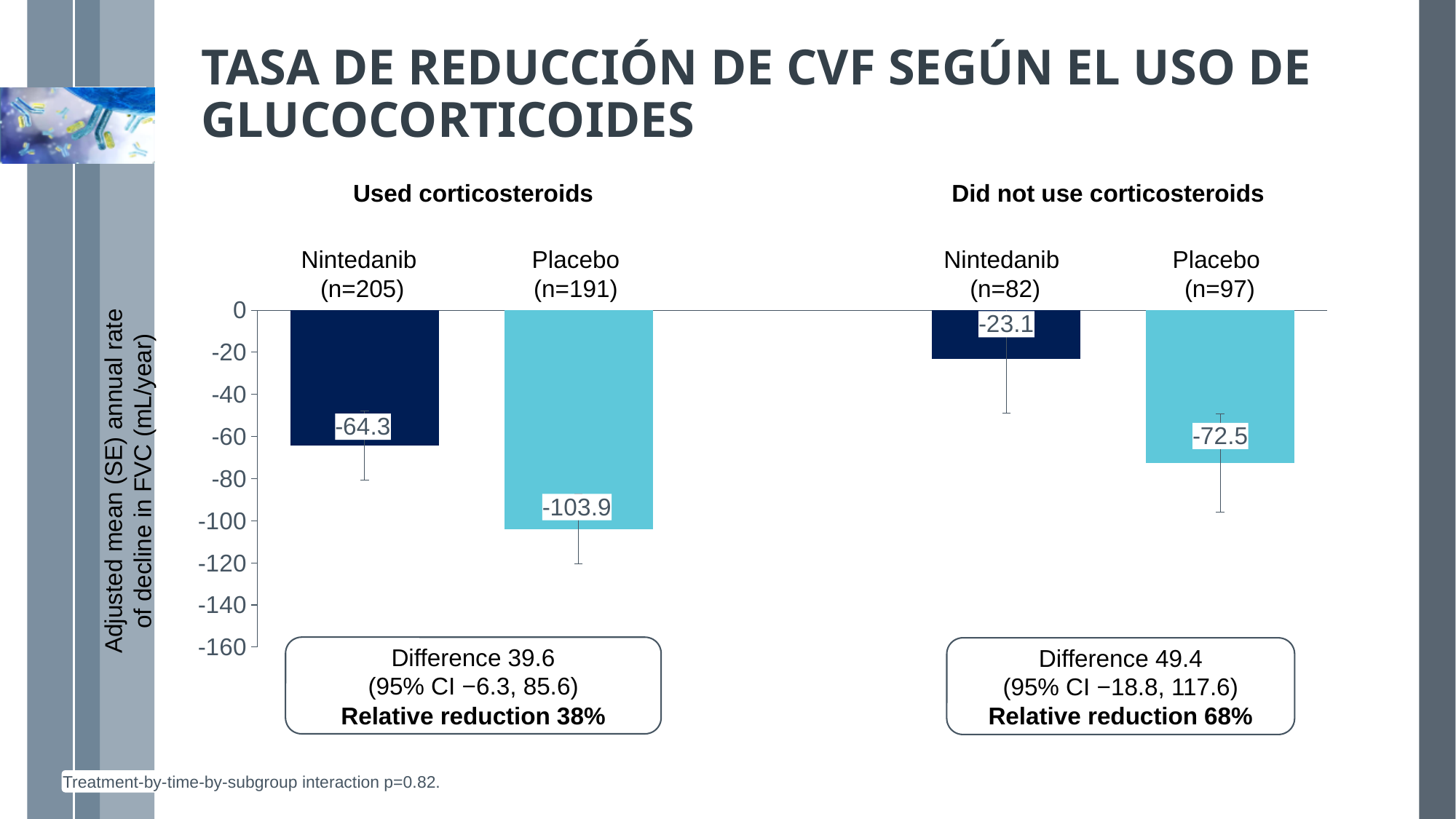
Which bar shows the largest decline in FVC (the most negative value)? Placebo (n=191), Used corticosteroids Which has a larger decline in FVC: Placebo in the 'Used corticosteroids' group or Placebo in the 'Did not use corticosteroids' group? Placebo in the 'Used corticosteroids' group What type of chart is shown on the slide? Bar chart Which bar shows the smallest decline in FVC (the value closest to 0)? Nintedanib (n=82), Did not use corticosteroids What is the adjusted mean annual rate of decline in FVC for Nintedanib (n=82) in the 'Did not use corticosteroids' group? -23.1 How many bars are plotted in the chart? 4 What is the difference between the Placebo and Nintedanib values in the 'Did not use corticosteroids' group? 49.4 What is the adjusted mean annual rate of decline in FVC for Nintedanib (n=205) in the 'Used corticosteroids' group? -64.3 What is the relative reduction reported for the 'Did not use corticosteroids' group? 68% What is the adjusted mean annual rate of decline in FVC for Placebo (n=191) in the 'Used corticosteroids' group? -103.9 What is the adjusted mean annual rate of decline in FVC for Placebo (n=97) in the 'Did not use corticosteroids' group? -72.5 What is the difference between the Placebo and Nintedanib values in the 'Used corticosteroids' group? 39.6